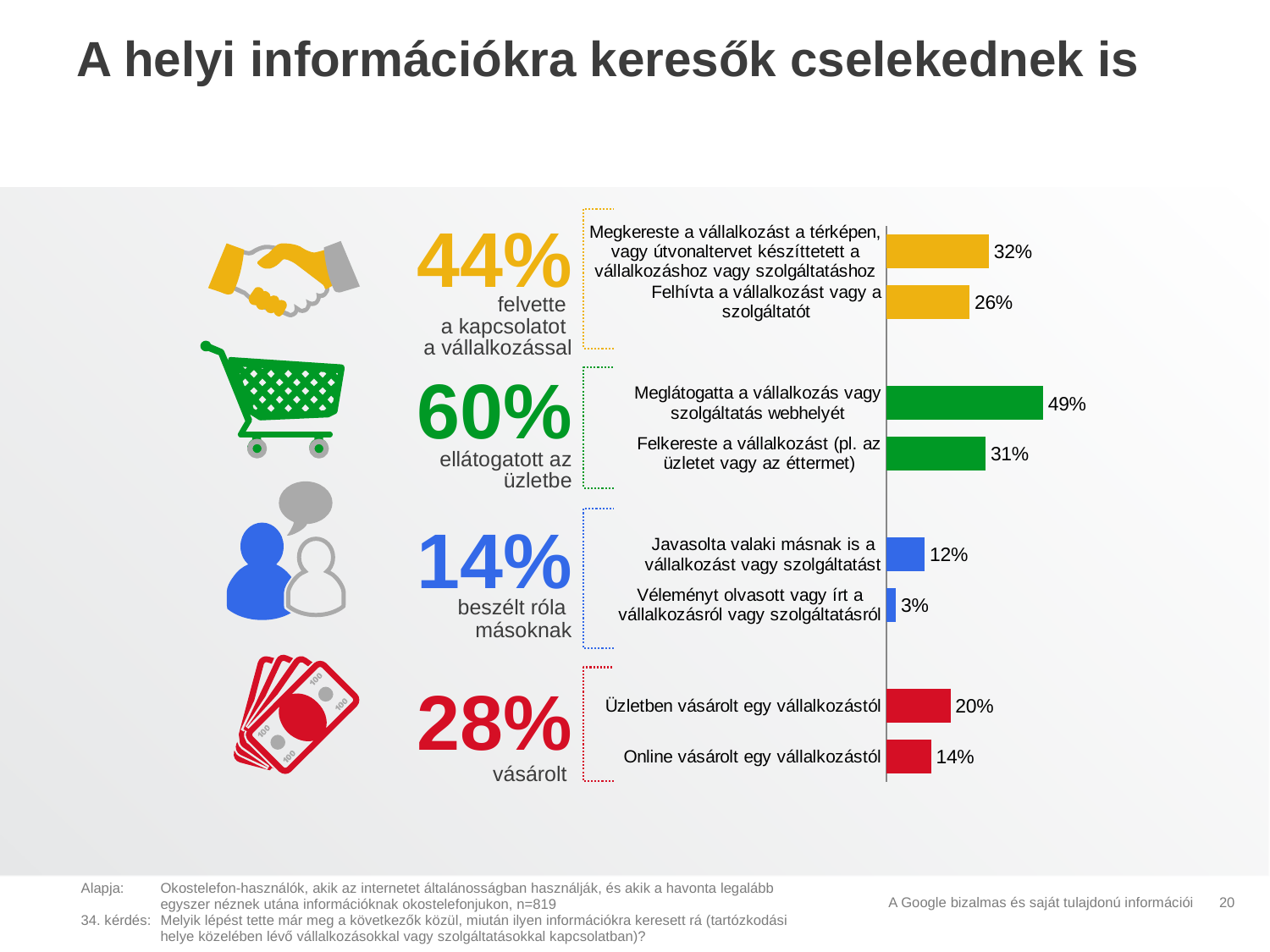
Which category has the highest value in the bar chart? Meglátogatta a vállalkozás vagy szolgáltatás webhelyét Which category has the lowest value in the bar chart? Véleményt olvasott vagy írt a vállalkozásról vagy szolgáltatásról What colour are the bars for the two purchase-related categories ('Üzletben vásárolt' and 'Online vásárolt')? Red What is the difference between the value for 'Üzletben vásárolt egy vállalkozástól' and 'Online vásárolt egy vállalkozástól'? 6% What large percentage is shown next to the shopping cart icon for 'ellátogatott az üzletbe'? 60% What percentage of respondents visited the business's or service's website (Meglátogatta a vállalkozás vagy szolgáltatás webhelyét)? 49% What is the difference between the value for 'Javasolta valaki másnak is a vállalkozást vagy szolgáltatást' and 'Véleményt olvasott vagy írt a vállalkozásról vagy szolgáltatásról'? 9% Which is larger: the value for 'Megkereste a vállalkozást a térképen...' or the value for 'Felkereste a vállalkozást (pl. az üzletet vagy az éttermet)'? Megkereste a vállalkozást a térképen... What type of chart is shown on the slide? Bar chart What percentage is shown for 'Online vásárolt egy vállalkozástól'? 14% What value is shown for 'Felhívta a vállalkozást vagy a szolgáltatót'? 26% How many categories (bars) are shown in the bar chart? 8